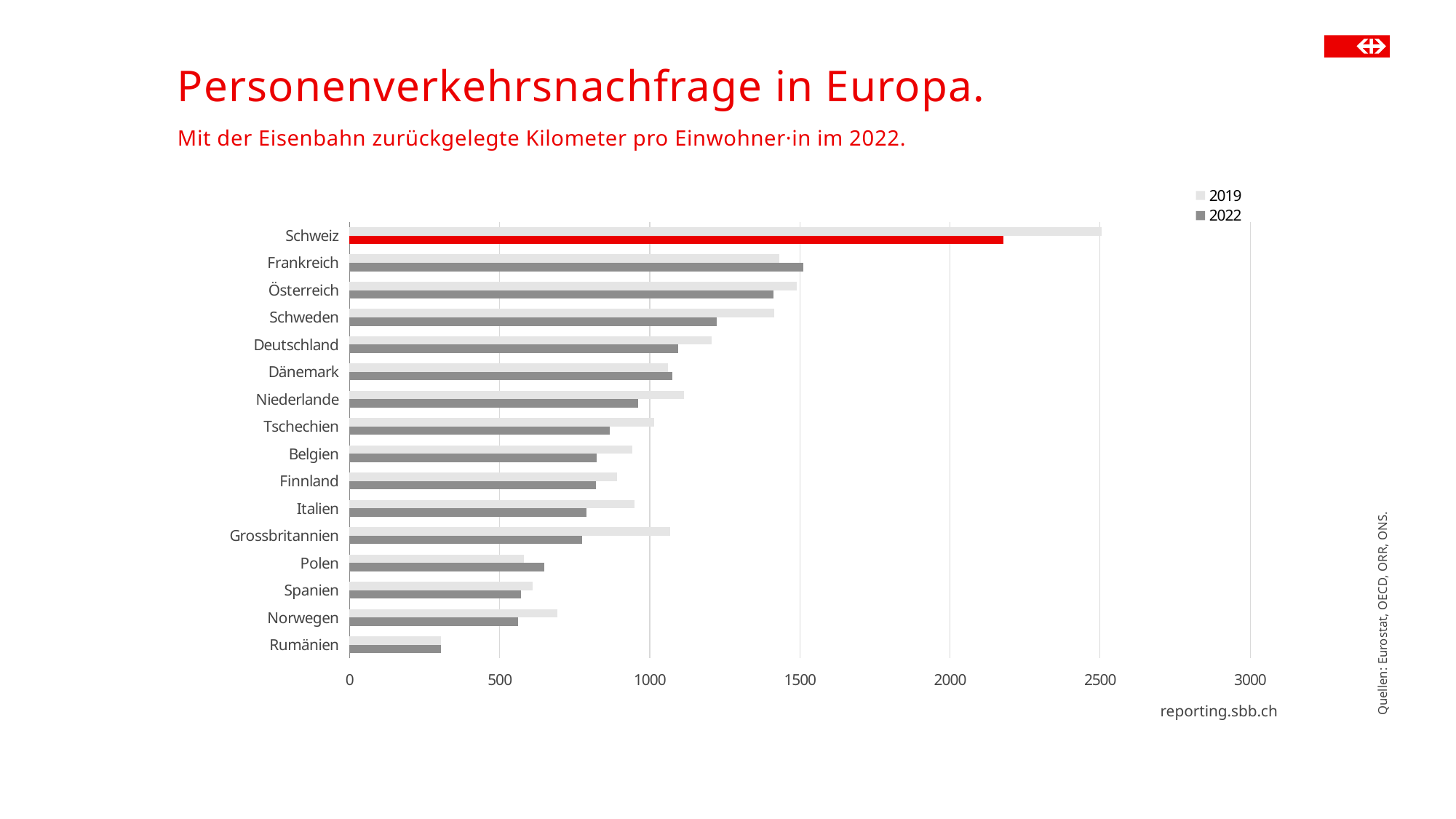
Which country has the lowest value for 2022? Rumänien Is the 2022 value for Grossbritannien greater or less than 1000? less How many series does the legend list? 2 Which is larger for Polen: the 2019 value or the 2022 value? 2022 Is the 2022 value for Schweiz greater or less than 2000? greater Which is larger for Schweden: the 2019 value or the 2022 value? 2019 Which country has the highest value for 2022? Schweiz How many countries are listed on the chart? 16 Which series is shown in red for Schweiz? 2022 What kind of chart is shown on the slide? bar chart